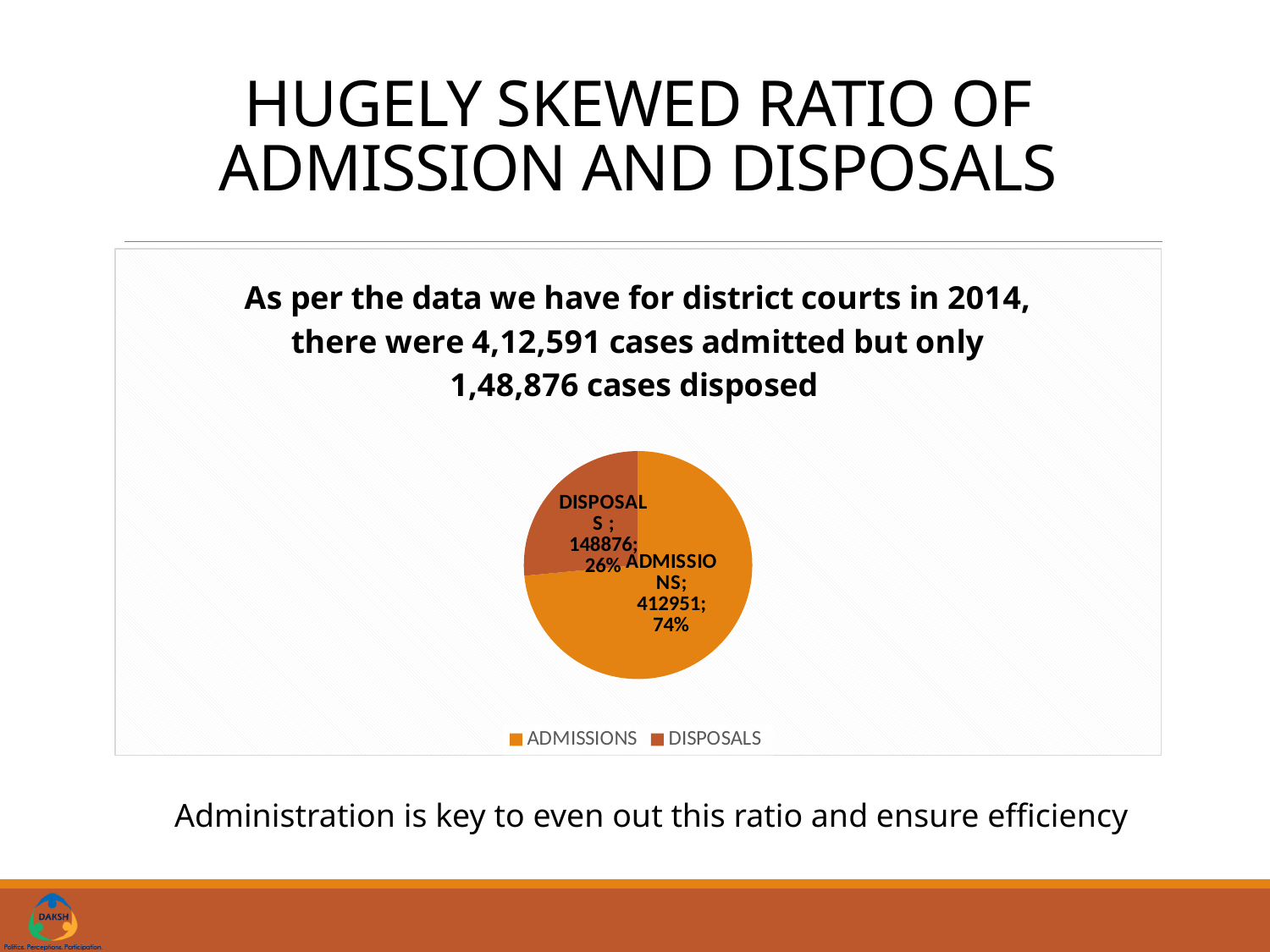
What kind of chart is shown on the slide? pie chart How many slices does the pie chart have? 2 How many entries does the legend of the pie chart list? 2 What value is shown for ADMISSIONS in the pie chart? 412951 Which slice of the pie chart is the largest? ADMISSIONS Which legend entry is shown in the darker brown colour in the pie chart? DISPOSALS Which slice of the pie chart is the smallest? DISPOSALS What percentage share of the pie does DISPOSALS have? 26% Which is larger in the pie chart, ADMISSIONS or DISPOSALS? ADMISSIONS What value is shown for DISPOSALS in the pie chart? 148876 What is the difference between the ADMISSIONS value and the DISPOSALS value in the pie chart? 264075 What percentage share of the pie does ADMISSIONS have? 74%